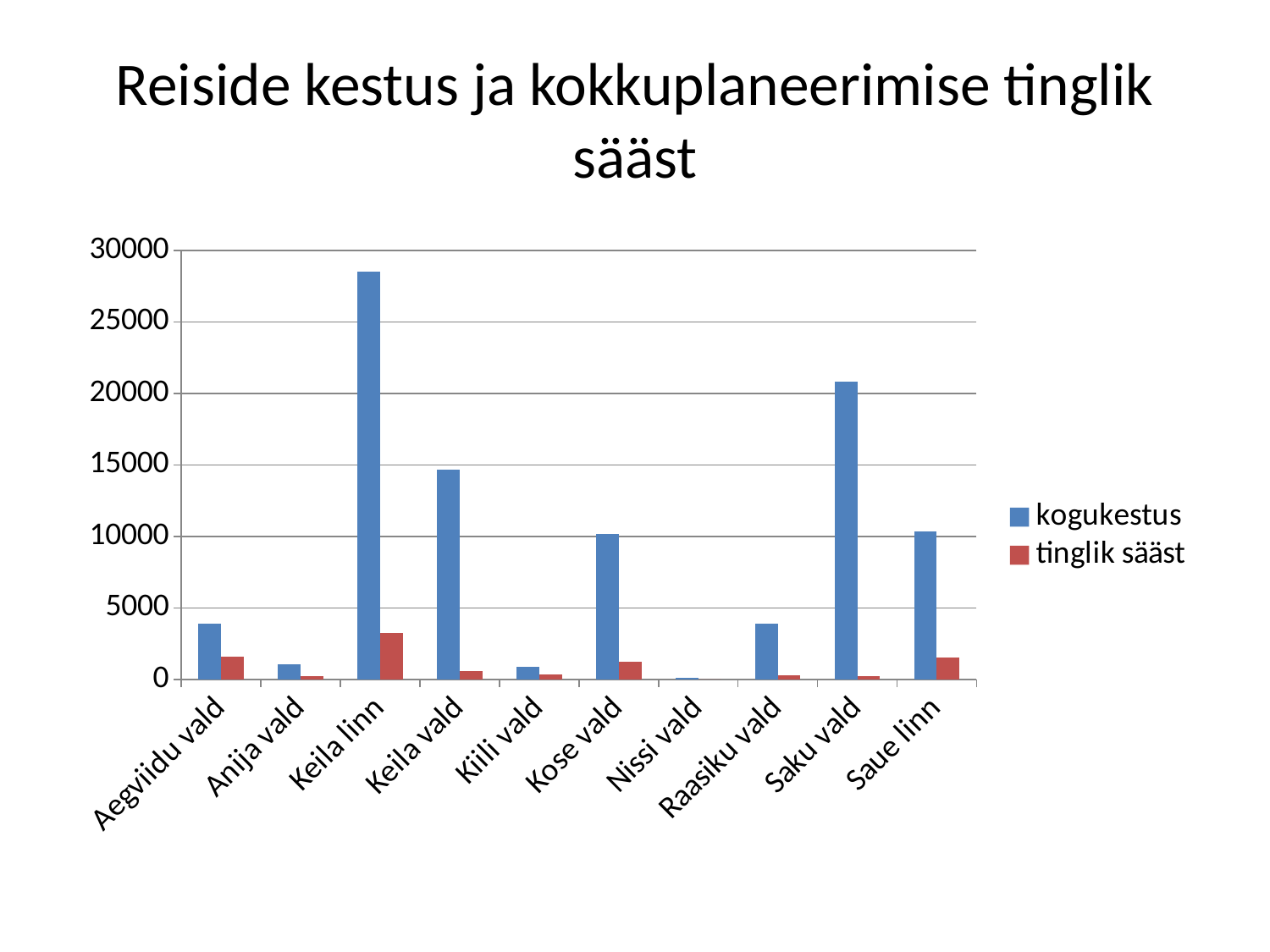
What kind of chart is shown on the slide? bar chart Which category has the highest kogukestus value? Keila linn How many series does the legend list? 2 Is the kogukestus value for Aegviidu vald greater or less than 5000? less Is the tinglik sääst value for Keila linn greater or less than 5000? less Which has a larger kogukestus value, Saku vald or Keila vald? Saku vald Is the kogukestus value for Keila linn greater or less than 25000? greater How many categories are shown on the x axis? 10 Which category has the highest tinglik sääst value? Keila linn What are the two series named in the legend? kogukestus and tinglik sääst Which category has the lowest kogukestus value? Nissi vald